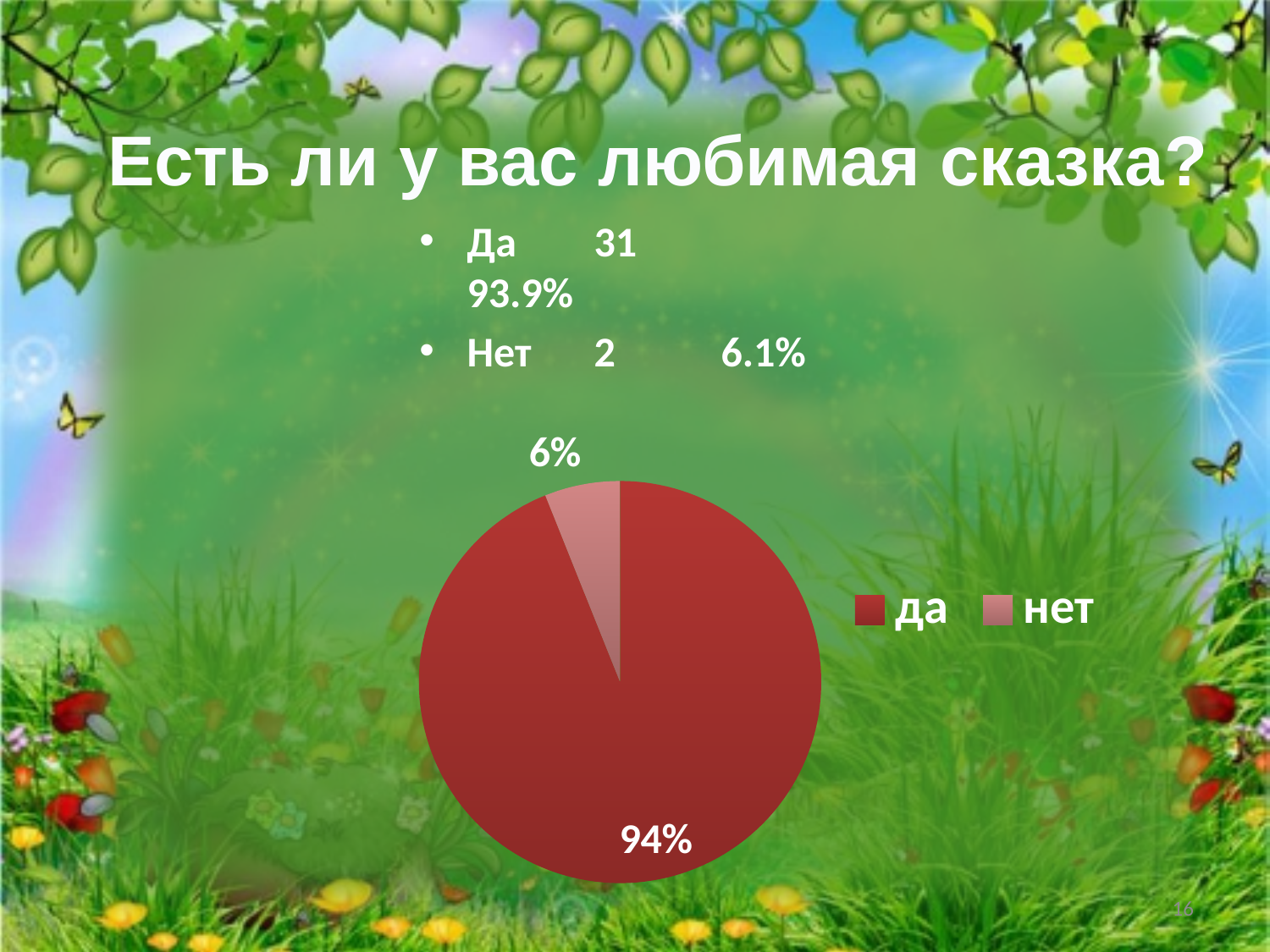
What colour is the "нет" slice in the pie chart? light pink What are the two legend entries of the pie chart? да, нет Which slice of the pie chart is the smallest? нет How many entries does the legend of the pie chart list? 2 What share of the pie does the "нет" slice have? 6% What kind of chart is shown on the slide? pie chart How many slices does the pie chart have? 2 What is the difference in percentage points between the "да" and "нет" slices? 88% What share of the pie does the "да" slice have? 94% Which is larger in the pie chart, "да" or "нет"? да Which slice of the pie chart is the largest? да